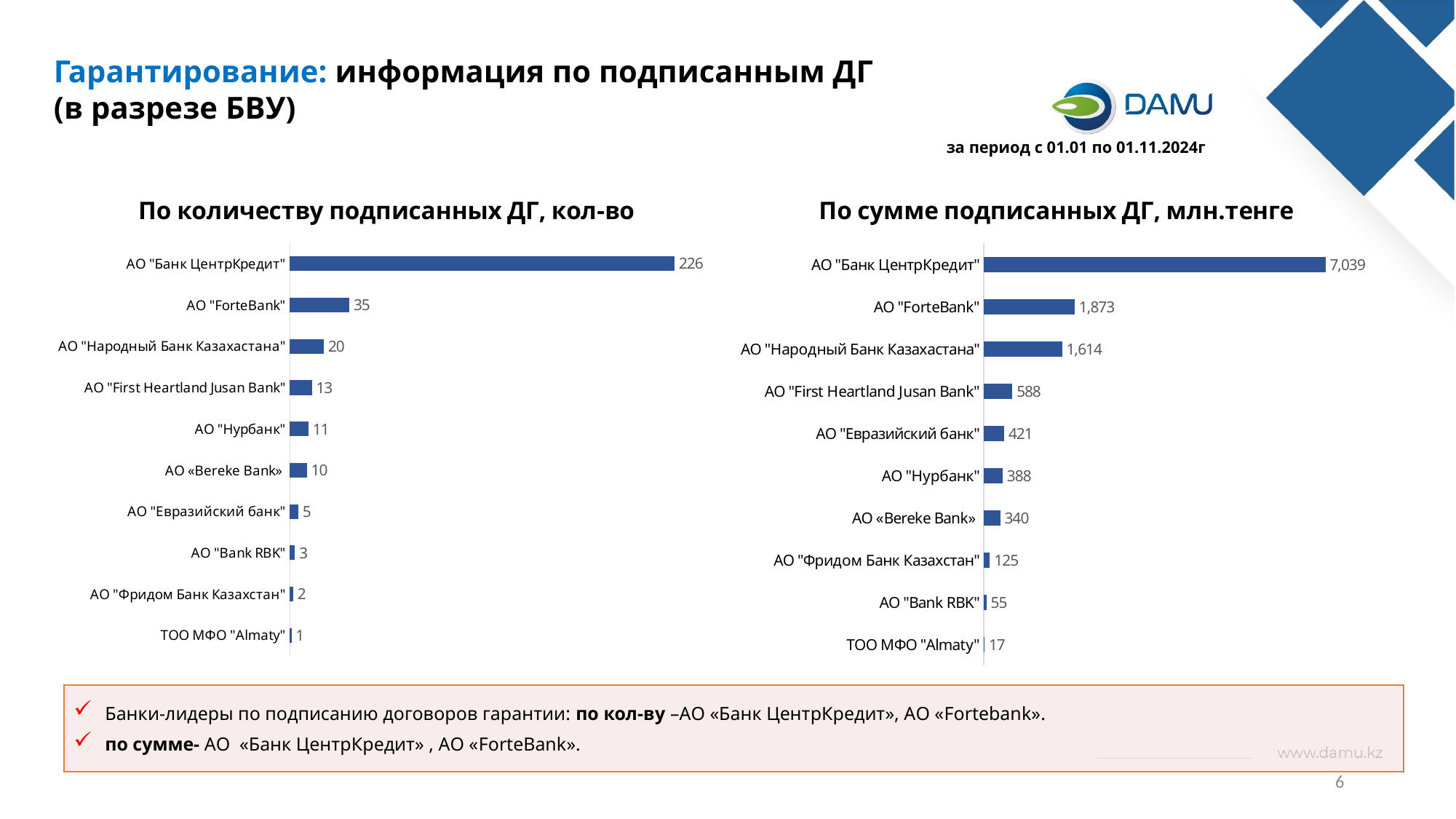
In the chart "По сумме подписанных ДГ, млн.тенге", what is the difference between АО "ForteBank" and АО "Народный Банк Казахастана"? 259 What type of chart is "По количеству подписанных ДГ, кол-во"? Bar chart In the chart "По количеству подписанных ДГ, кол-во", what is the difference between АО "Банк ЦентрКредит" and АО "ForteBank"? 191 How many categories are shown in the chart "По сумме подписанных ДГ, млн.тенге"? 10 In the chart "По количеству подписанных ДГ, кол-во", what is the value for АО "ForteBank"? 35 In the chart "По сумме подписанных ДГ, млн.тенге", which is larger: АО "Нурбанк" or АО «Bereke Bank»? АО "Нурбанк" In the chart "По количеству подписанных ДГ, кол-во", which bank has the highest value? АО "Банк ЦентрКредит" In the chart "По сумме подписанных ДГ, млн.тенге", what is the value for АО "Евразийский банк"? 421 In the chart "По сумме подписанных ДГ, млн.тенге", which category has the lowest value? ТОО МФО "Almaty" In the chart "По количеству подписанных ДГ, кол-во", which is larger: АО "Евразийский банк" or АО "Bank RBK"? АО "Евразийский банк" In the chart "По количеству подписанных ДГ, кол-во", what is the value for ТОО МФО "Almaty"? 1 In the chart "По сумме подписанных ДГ, млн.тенге", what is the value for АО "Народный Банк Казахастана"? 1,614